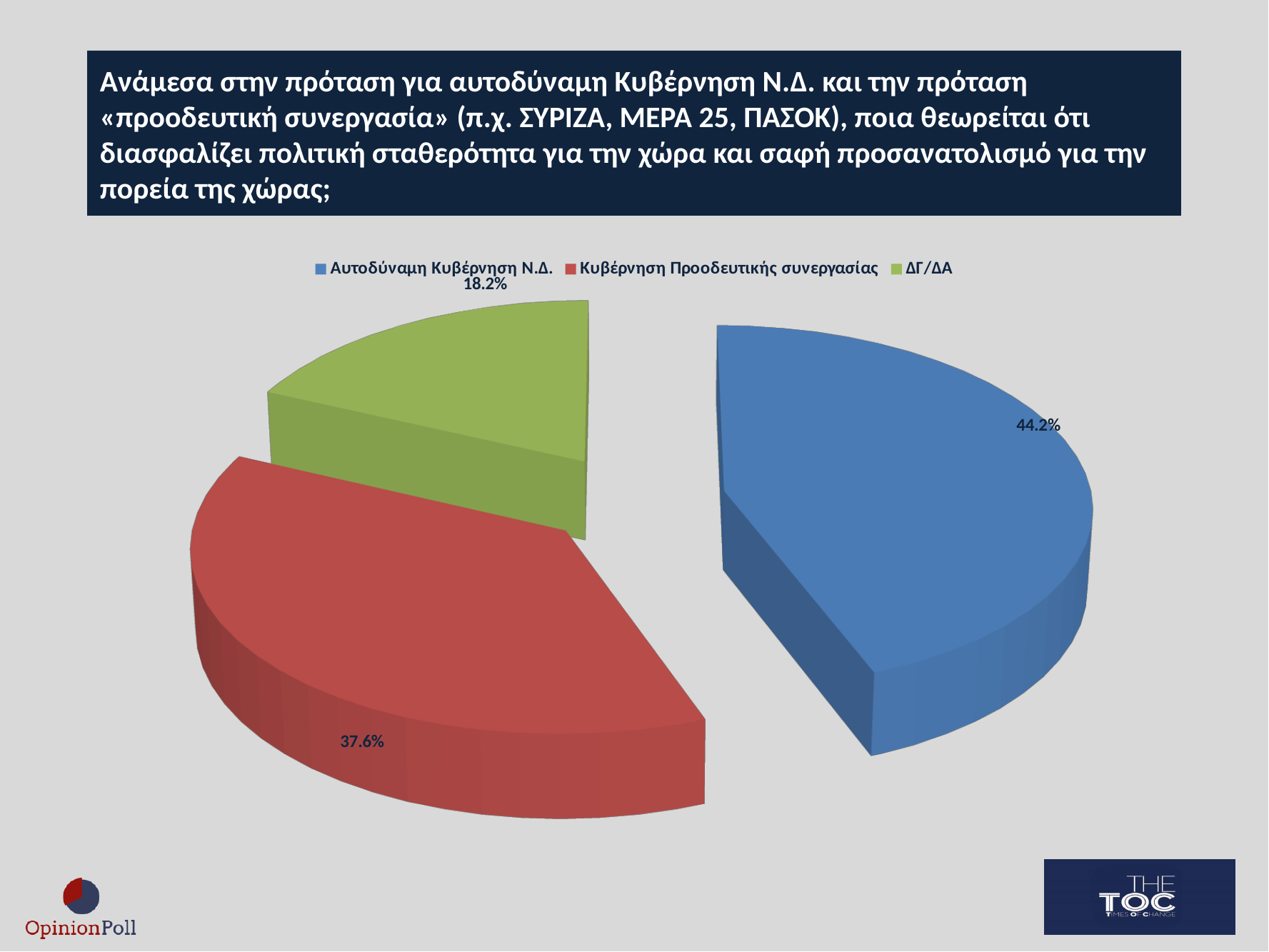
What percentage of the pie is labelled for Αυτοδύναμη Κυβέρνηση Ν.Δ.? 44.2% What percentage of the pie is labelled for Κυβέρνηση Προοδευτικής συνεργασίας? 37.6% What is the difference in percentage points between Κυβέρνηση Προοδευτικής συνεργασίας and ΔΓ/ΔΑ? 19.4 What is the difference in percentage points between Αυτοδύναμη Κυβέρνηση Ν.Δ. and Κυβέρνηση Προοδευτικής συνεργασίας? 6.6 Which category has the smallest slice of the pie? ΔΓ/ΔΑ What kind of chart is shown on the slide? Pie chart What colour is the slice for Αυτοδύναμη Κυβέρνηση Ν.Δ.? Blue Which is larger: the slice for Κυβέρνηση Προοδευτικής συνεργασίας or the slice for ΔΓ/ΔΑ? Κυβέρνηση Προοδευτικής συνεργασίας What percentage of the pie is labelled for ΔΓ/ΔΑ? 18.2% Which category has the largest slice of the pie? Αυτοδύναμη Κυβέρνηση Ν.Δ. What colour is the slice for ΔΓ/ΔΑ? Green How many slices does the pie chart have? 3